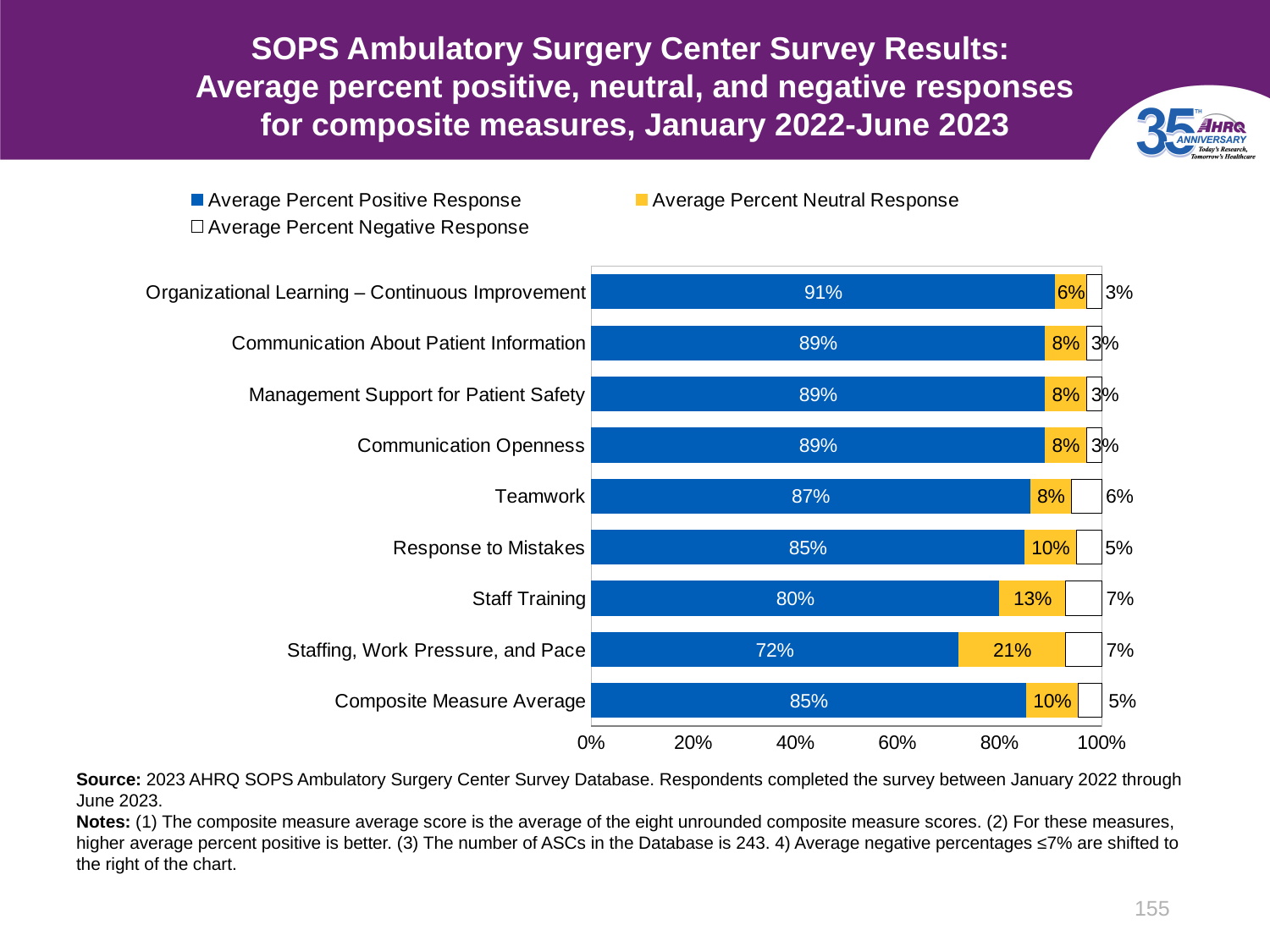
What is the Average Percent Negative Response for Teamwork? 6% What is the Average Percent Neutral Response for Staffing, Work Pressure, and Pace? 21% How many series does the legend list? 3 Which composite measure has the lowest Average Percent Positive Response? Staffing, Work Pressure, and Pace What is the Average Percent Positive Response for Organizational Learning – Continuous Improvement? 91% What is the difference in Average Percent Positive Response between Organizational Learning – Continuous Improvement and Staffing, Work Pressure, and Pace? 19 percentage points What is the Average Percent Positive Response for the Composite Measure Average? 85% What is the total of the positive, neutral, and negative percentages for Staff Training? 100% How many composite measures (bars) are shown in the chart? 9 Which composite measure has the highest Average Percent Positive Response? Organizational Learning – Continuous Improvement Which has a higher Average Percent Neutral Response, Staff Training or Response to Mistakes? Staff Training What kind of chart is shown on the slide? Stacked horizontal bar chart